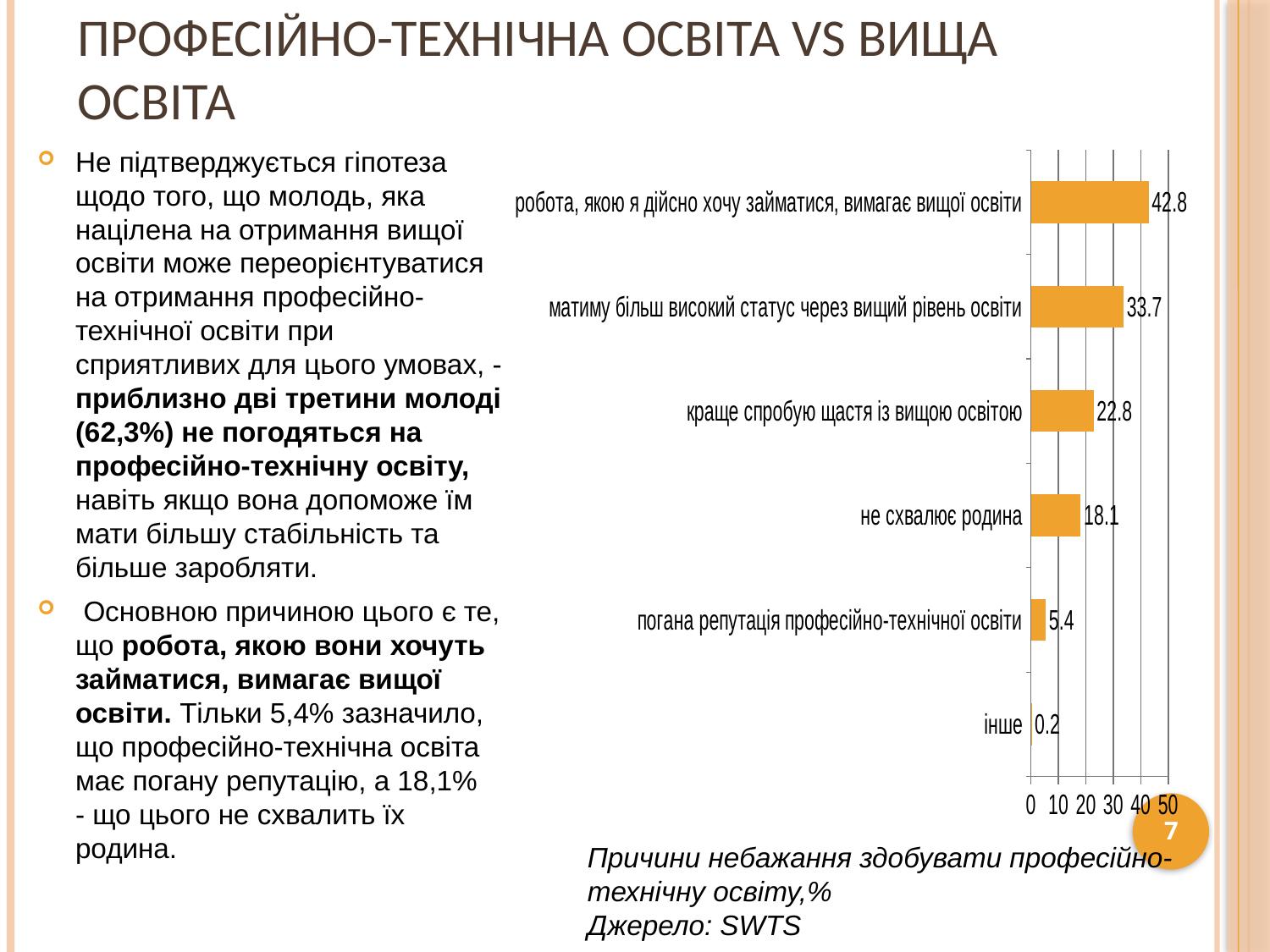
What colour are the bars in the chart? orange What is the difference between the values for "матиму більш високий статус через вищий рівень освіти" and "краще спробую щастя із вищою освітою"? 10.9 Is the value for "матиму більш високий статус через вищий рівень освіти" greater or less than 30? greater What kind of chart is shown on the slide? bar chart What is the value for "робота, якою я дійсно хочу займатися, вимагає вищої освіти"? 42.8 What is the value for "погана репутація професійно-технічної освіти"? 5.4 Which category has the lowest value? інше What is the value for "інше"? 0.2 What is the value for "не схвалює родина"? 18.1 Which is larger: the value for "не схвалює родина" or the value for "погана репутація професійно-технічної освіти"? не схвалює родина How many categories are shown in the chart? 6 Which category has the highest value? робота, якою я дійсно хочу займатися, вимагає вищої освіти